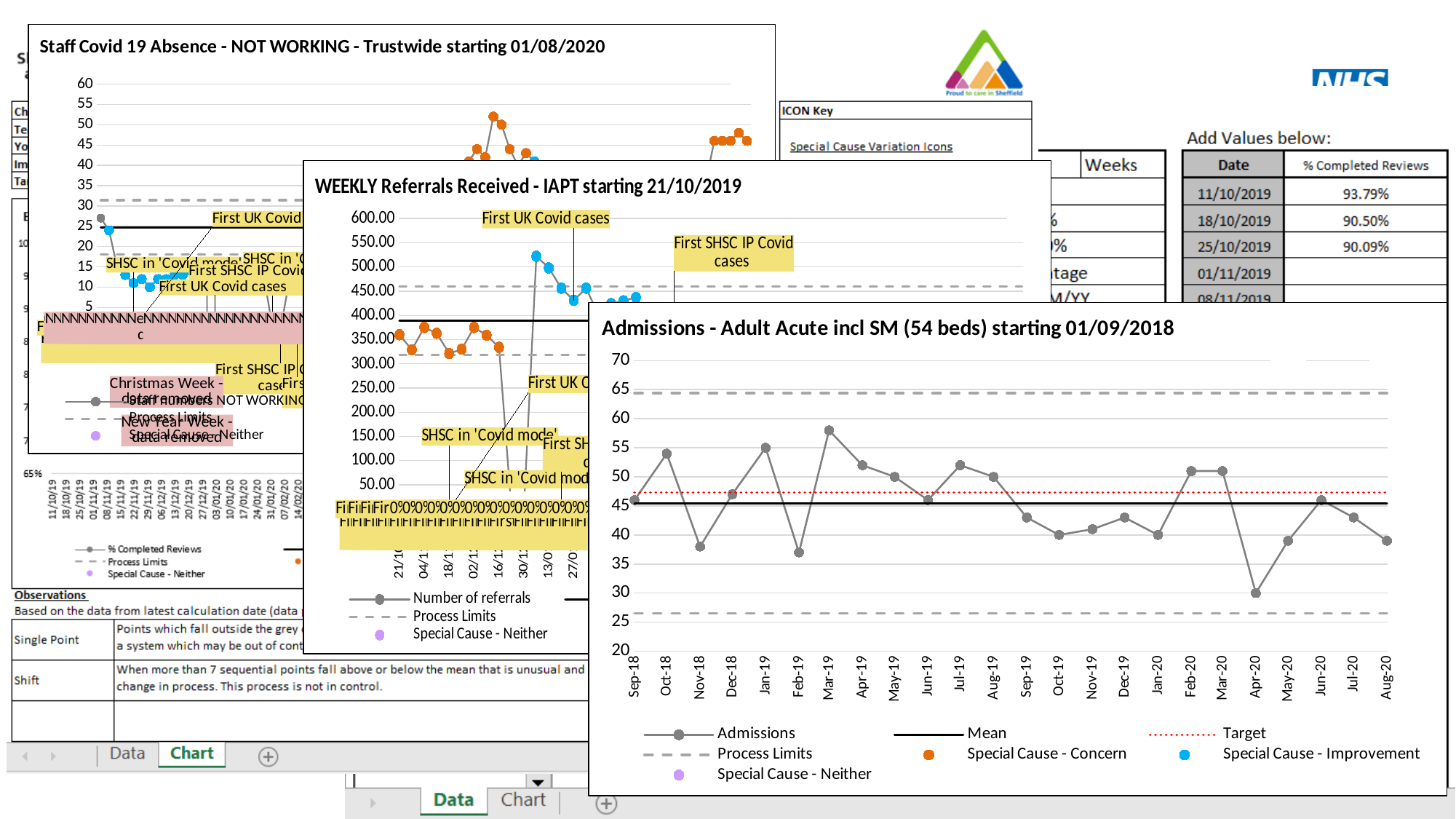
In the 'Admissions - Adult Acute incl SM (54 beds)' chart, what colour is the 'Special Cause - Improvement' legend marker? Blue In the 'Admissions - Adult Acute incl SM (54 beds)' chart, is the value for Feb-19 greater or less than 40? less In the 'Admissions - Adult Acute incl SM (54 beds)' chart, is the value for Apr-20 greater or less than 35? less What type of chart is the 'Admissions - Adult Acute incl SM (54 beds) starting 01/09/2018' chart? Line chart In the 'Admissions - Adult Acute incl SM (54 beds)' chart, is the value for Oct-18 greater or less than 50? greater In the 'Admissions - Adult Acute incl SM (54 beds)' chart, which month has the lowest number of admissions? Apr-20 In the 'Admissions - Adult Acute incl SM (54 beds)' chart, how many monthly data points are plotted on the x axis? 24 How many entries does the legend of the 'Admissions - Adult Acute incl SM (54 beds)' chart list? 7 In the 'Admissions - Adult Acute incl SM (54 beds)' chart, which month has the highest number of admissions? Mar-19 What is the title of the chart in the bottom right of the slide? Admissions - Adult Acute incl SM (54 beds) starting 01/09/2018 In the 'Admissions - Adult Acute incl SM (54 beds)' chart, which is larger, the value for Oct-18 or the value for Nov-18? Oct-18